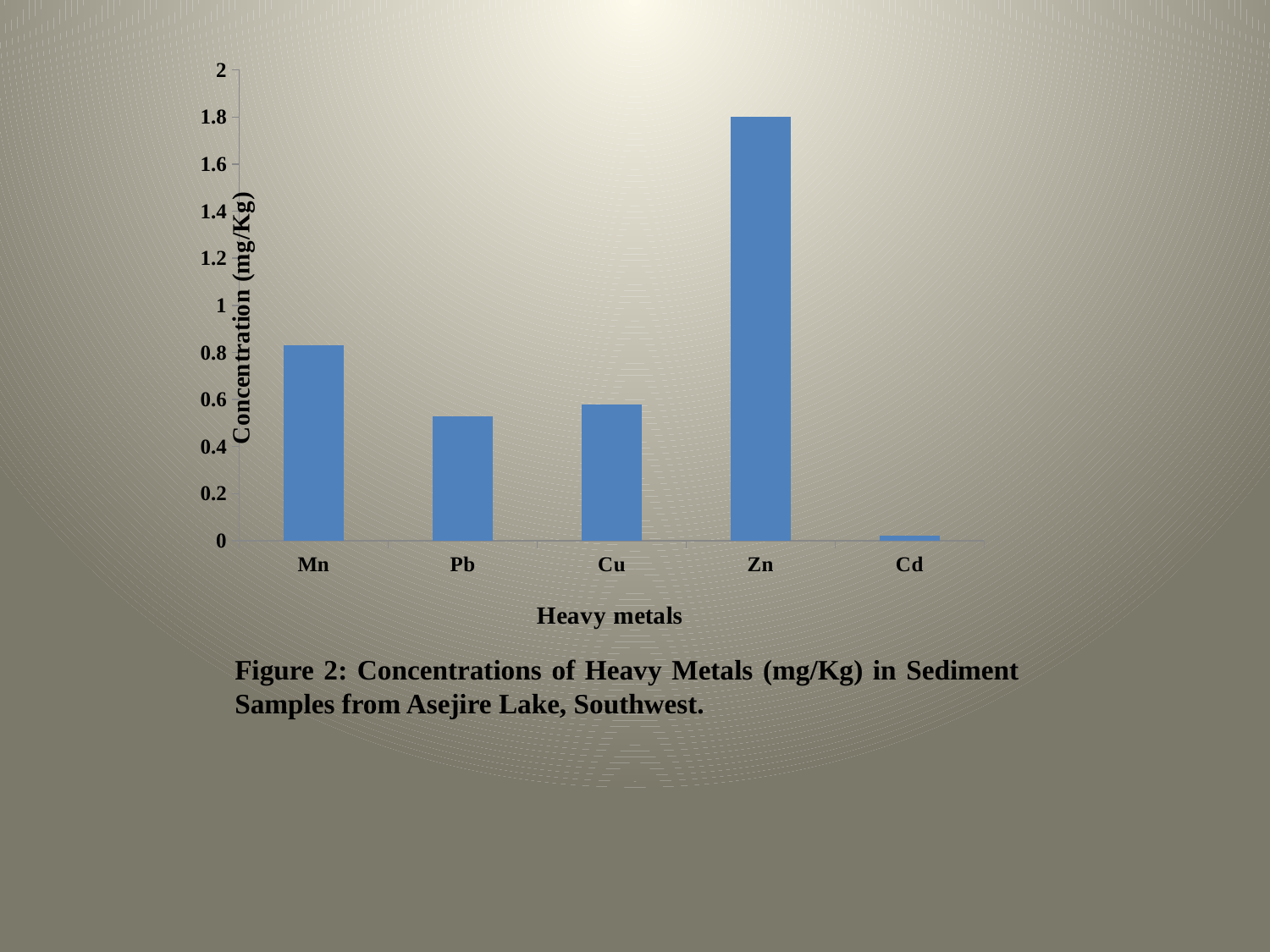
Is the value for Cd greater or less than 0.2? less Is the value for Pb greater or less than 0.6? less Which heavy metal has the highest concentration? Zn How many heavy metals are plotted on the x axis? 5 Which has a higher concentration, Mn or Pb? Mn What is the label of the x axis? Heavy metals What is the label of the y axis? Concentration (mg/Kg) Is the value for Mn greater or less than 1? less What is the concentration (mg/Kg) for Zn? 1.8 What kind of chart is shown on the slide? bar chart Which heavy metal has the lowest concentration? Cd